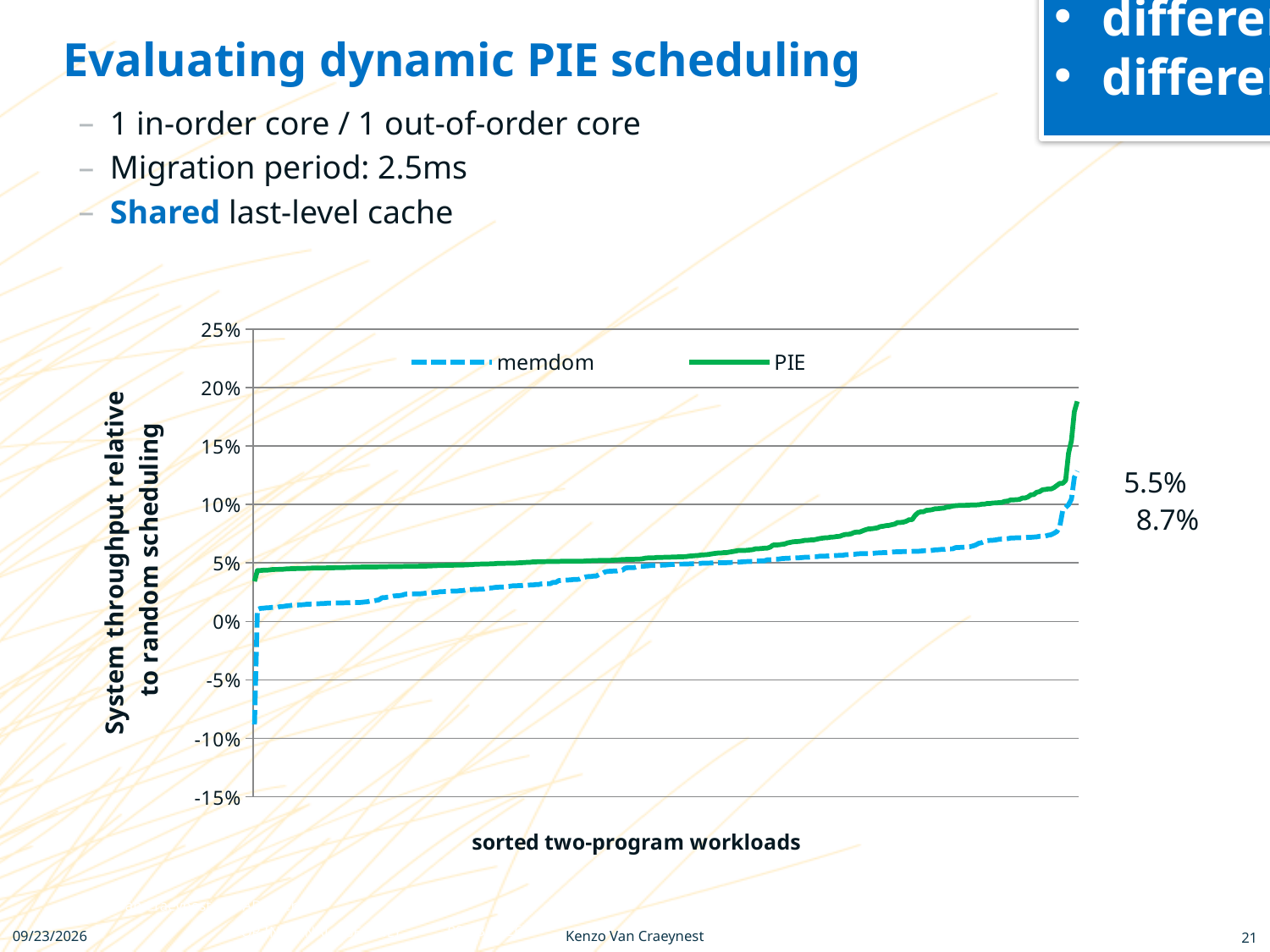
At the left end of the chart, which series has the lower value, memdom or PIE? memdom What are the two series named in the chart's legend? memdom and PIE How many series does the chart's legend list? 2 Is the lowest value of the PIE series greater or less than 0%? greater Is the lowest value of the memdom series greater or less than -5%? less Do the values of the PIE series rise or fall from left to right along the x axis? rise What is the highest value shown on the chart's y axis? 25% At the right end of the chart, which series reaches the higher value, memdom or PIE? PIE What is the label of the chart's x axis? sorted two-program workloads Is the highest value of the PIE series greater or less than 15%? greater Do the values of the memdom series rise or fall from left to right along the x axis? rise What kind of chart is shown on the slide? line chart